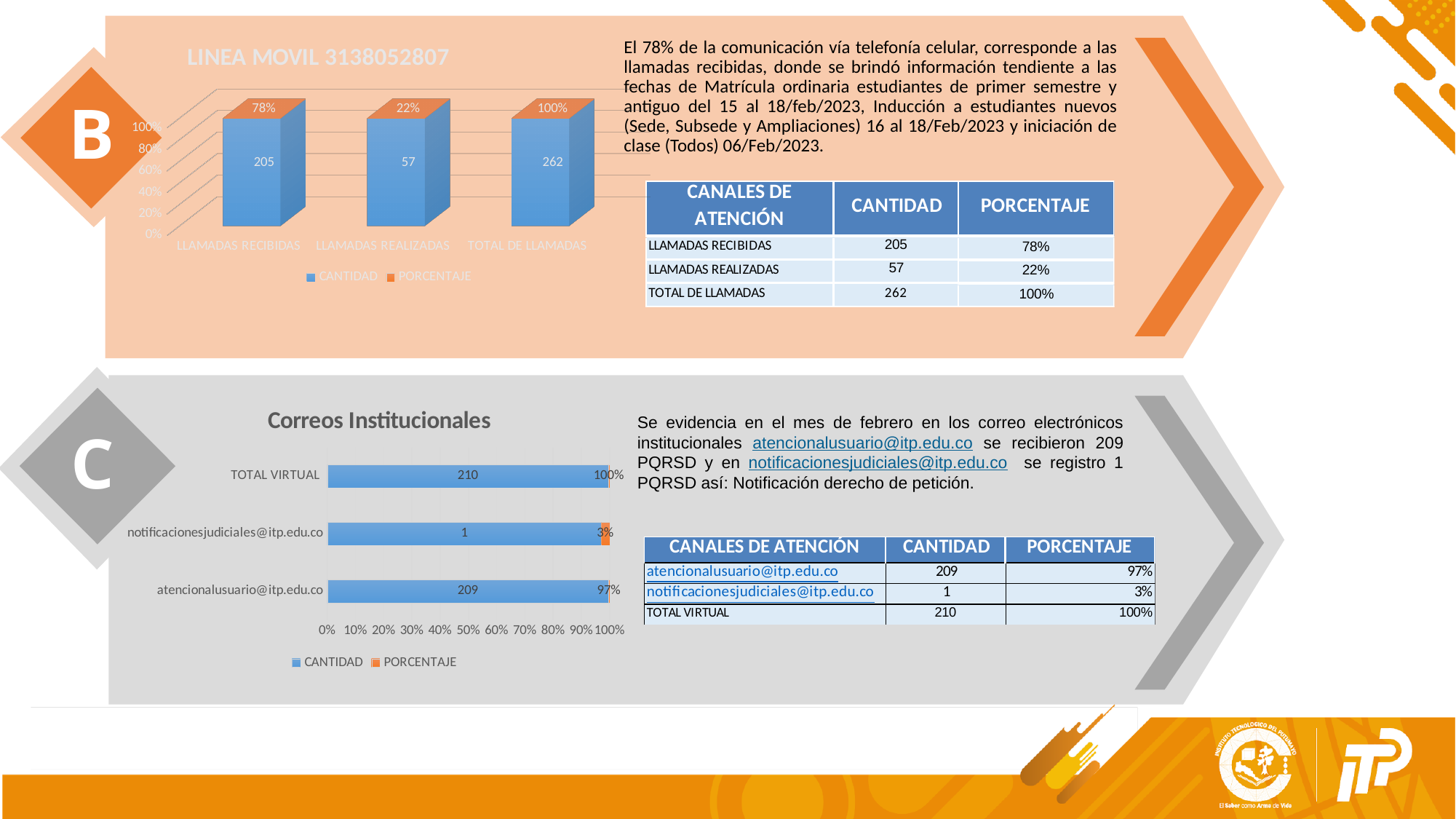
In the LINEA MOVIL 3138052807 chart, what is the CANTIDAD value for LLAMADAS RECIBIDAS? 205 What type of chart is the Correos Institucionales chart? Bar chart In the Correos Institucionales chart, what PORCENTAJE is shown for notificacionesjudiciales@itp.edu.co? 3% How many series does the legend of the LINEA MOVIL 3138052807 chart list? 2 In the Correos Institucionales chart, which has a larger CANTIDAD: atencionalusuario@itp.edu.co or notificacionesjudiciales@itp.edu.co? atencionalusuario@itp.edu.co In the Correos Institucionales chart, what is the CANTIDAD value for atencionalusuario@itp.edu.co? 209 In the LINEA MOVIL 3138052807 chart, which category has the lowest CANTIDAD? LLAMADAS REALIZADAS In the Correos Institucionales chart, which category has the highest CANTIDAD? TOTAL VIRTUAL In the LINEA MOVIL 3138052807 chart, what is the CANTIDAD value for TOTAL DE LLAMADAS? 262 In the LINEA MOVIL 3138052807 chart, what is the difference in CANTIDAD between LLAMADAS RECIBIDAS and LLAMADAS REALIZADAS? 148 How many categories are shown in the Correos Institucionales chart? 3 In the LINEA MOVIL 3138052807 chart, what PORCENTAJE is shown for LLAMADAS REALIZADAS? 22%